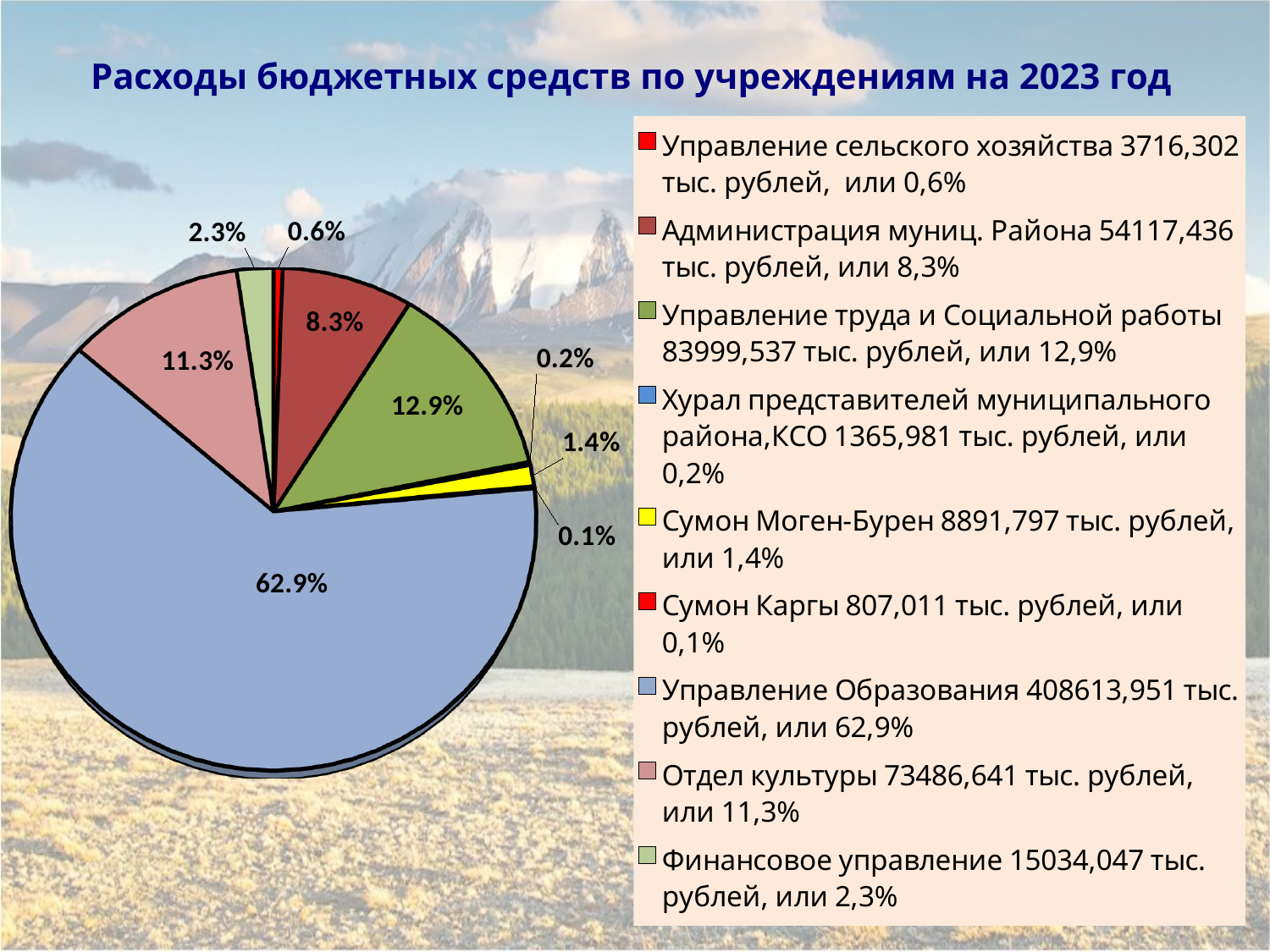
Which institution has the largest share of budget expenditures in the pie chart? Управление Образования Which has a larger share: Сумон Моген-Бурен or Финансовое управление? Финансовое управление Which institution has the smallest share of budget expenditures in the pie chart? Сумон Каргы According to the legend, how much is spent on Финансовое управление in thousand rubles? 15034,047 тыс. рублей What share of budget expenditures goes to Отдел культуры? 11.3% What is the title of the chart on the slide? Расходы бюджетных средств по учреждениям на 2023 год What share of budget expenditures goes to Управление Образования? 62.9% What is the difference in percentage points between the shares of Управление труда и Социальной работы and Администрация муниц. Района? 4.6 According to the legend, how much is spent on Администрация муниц. Района in thousand rubles? 54117,436 тыс. рублей How many categories (slices) does the pie chart have? 9 What kind of chart is shown on the slide? pie chart What share of budget expenditures goes to Управление труда и Социальной работы? 12.9%